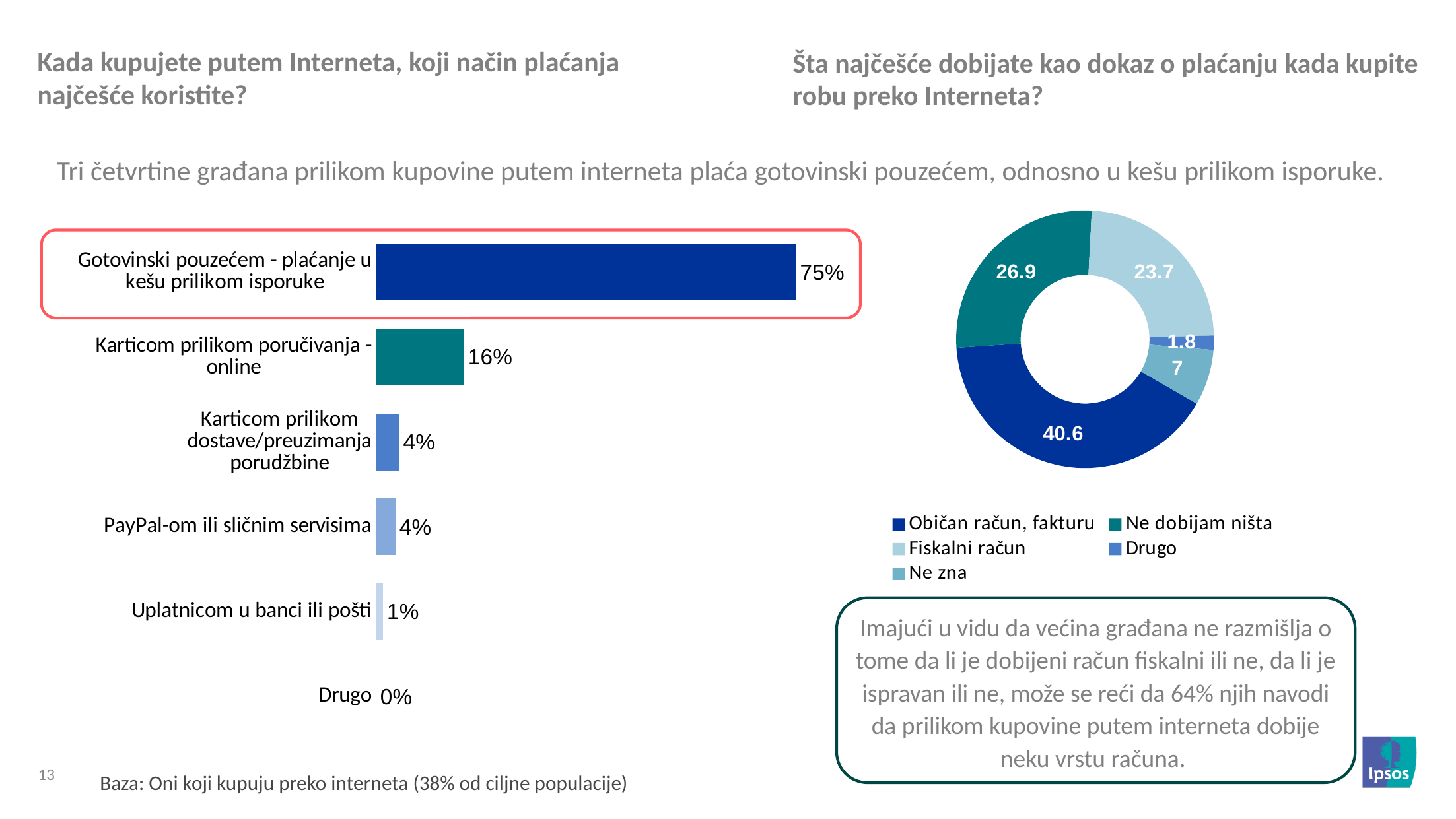
In the bar chart on the left, which category has the lowest value? Drugo In the donut chart on the right, which is larger: 'Fiskalni račun' or 'Ne zna'? Fiskalni račun In the donut chart on the right, which category has the smallest share? Drugo In the bar chart on the left, which category has the highest value? Gotovinski pouzećem - plaćanje u kešu prilikom isporuke In the bar chart on the left, what is the difference between 'Gotovinski pouzećem - plaćanje u kešu prilikom isporuke' and 'Karticom prilikom poručivanja - online'? 59% In the donut chart on the right, what is the value for 'Ne dobijam ništa'? 26.9 In the donut chart on the right, what is the value for 'Običan račun, fakturu'? 40.6 In the bar chart on the left, what is the value for 'Karticom prilikom poručivanja - online'? 16% In the bar chart on the left, how many categories are shown? 6 In the bar chart on the left, what is the value for 'Gotovinski pouzećem - plaćanje u kešu prilikom isporuke'? 75% What kind of chart is the chart on the left? bar chart How many entries does the legend of the donut chart on the right list? 5